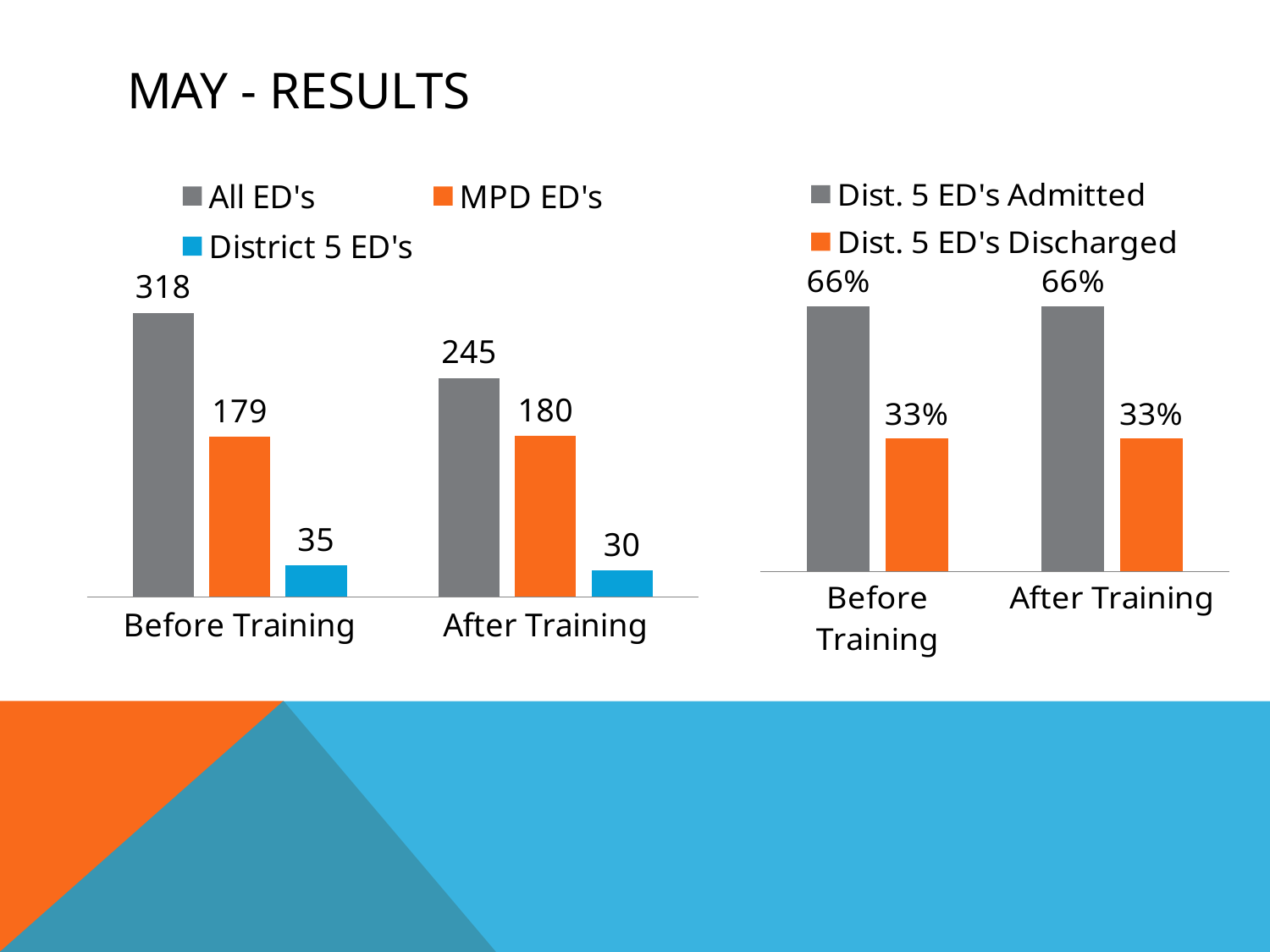
In the left chart, what is the value for District 5 ED's before training? 35 In the left chart, what is the difference between All ED's before training and All ED's after training? 73 In the right chart, what is the value for Dist. 5 ED's Discharged before training? 33% What kind of chart is the left chart? Bar chart In the right chart, what is the value for Dist. 5 ED's Admitted after training? 66% In the left chart, what is the value for MPD ED's after training? 180 How many categories are shown on the x axis of the right chart? 2 In the left chart, is the value for District 5 ED's larger before training or after training? Before Training In the left chart, what is the value for All ED's before training? 318 In the left chart, which series has the lowest value after training? District 5 ED's How many series does the legend of the left chart list? 3 In the right chart, what is the difference between Dist. 5 ED's Admitted and Dist. 5 ED's Discharged before training? 33%